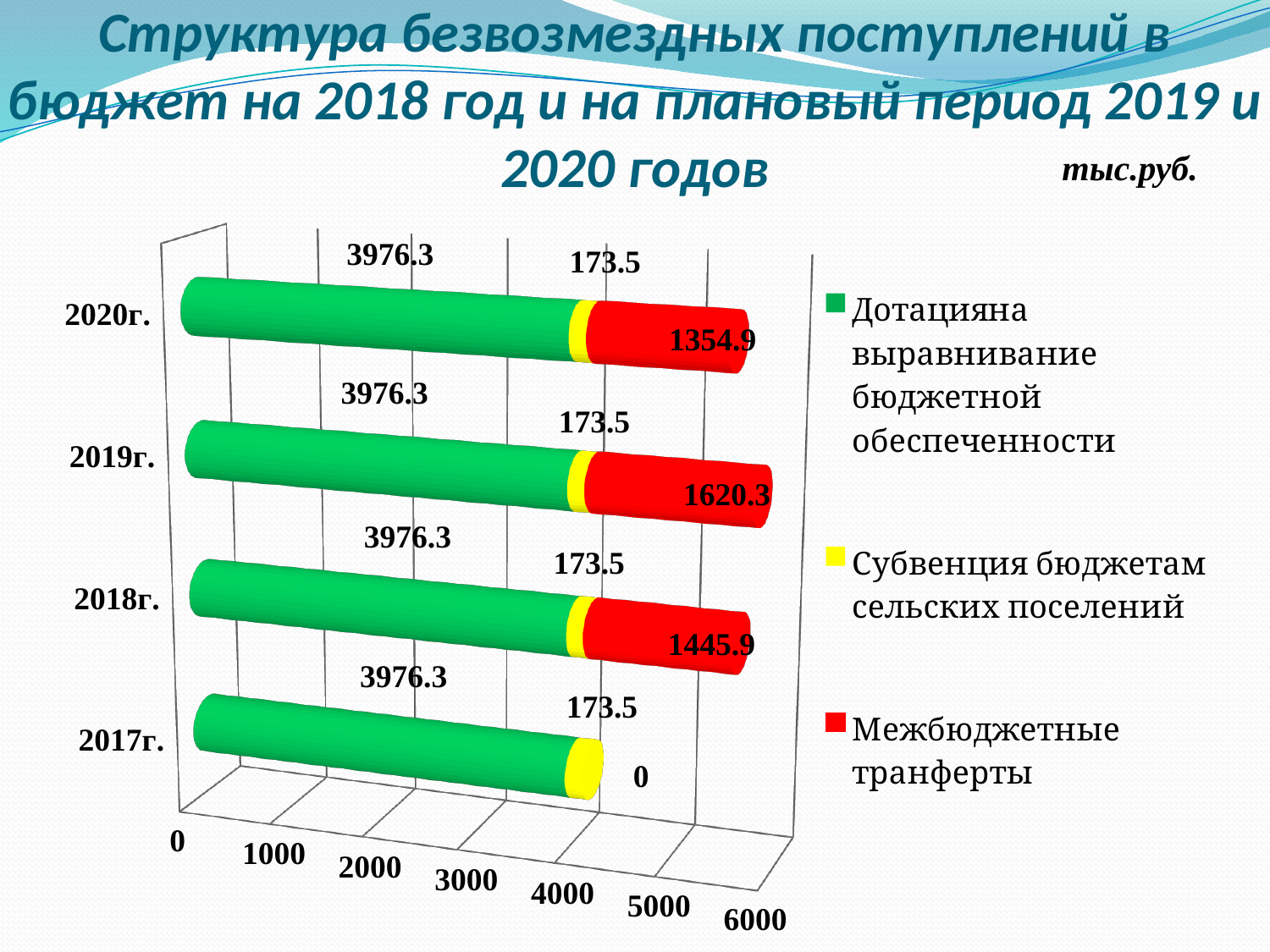
What is the value of Межбюджетные трансферты for 2019г.? 1620.3 What is the value of Межбюджетные трансферты for 2017г.? 0 Which is larger: Межбюджетные трансферты for 2018г. or for 2020г.? 2018г. What is the total of the stacked bar for 2018г.? 5595.7 How many years (categories) are shown on the chart? 4 In which year is the value of Межбюджетные трансферты the lowest? 2017г. What is the value of Дотация на выравнивание бюджетной обеспеченности for 2018г.? 3976.3 What is the difference between the Межбюджетные трансферты values for 2019г. and 2018г.? 174.4 How many series does the legend list? 3 What kind of chart is shown on the slide? Stacked bar chart In which year is the value of Межбюджетные трансферты the highest? 2019г. What is the value of Субвенция бюджетам сельских поселений for 2020г.? 173.5